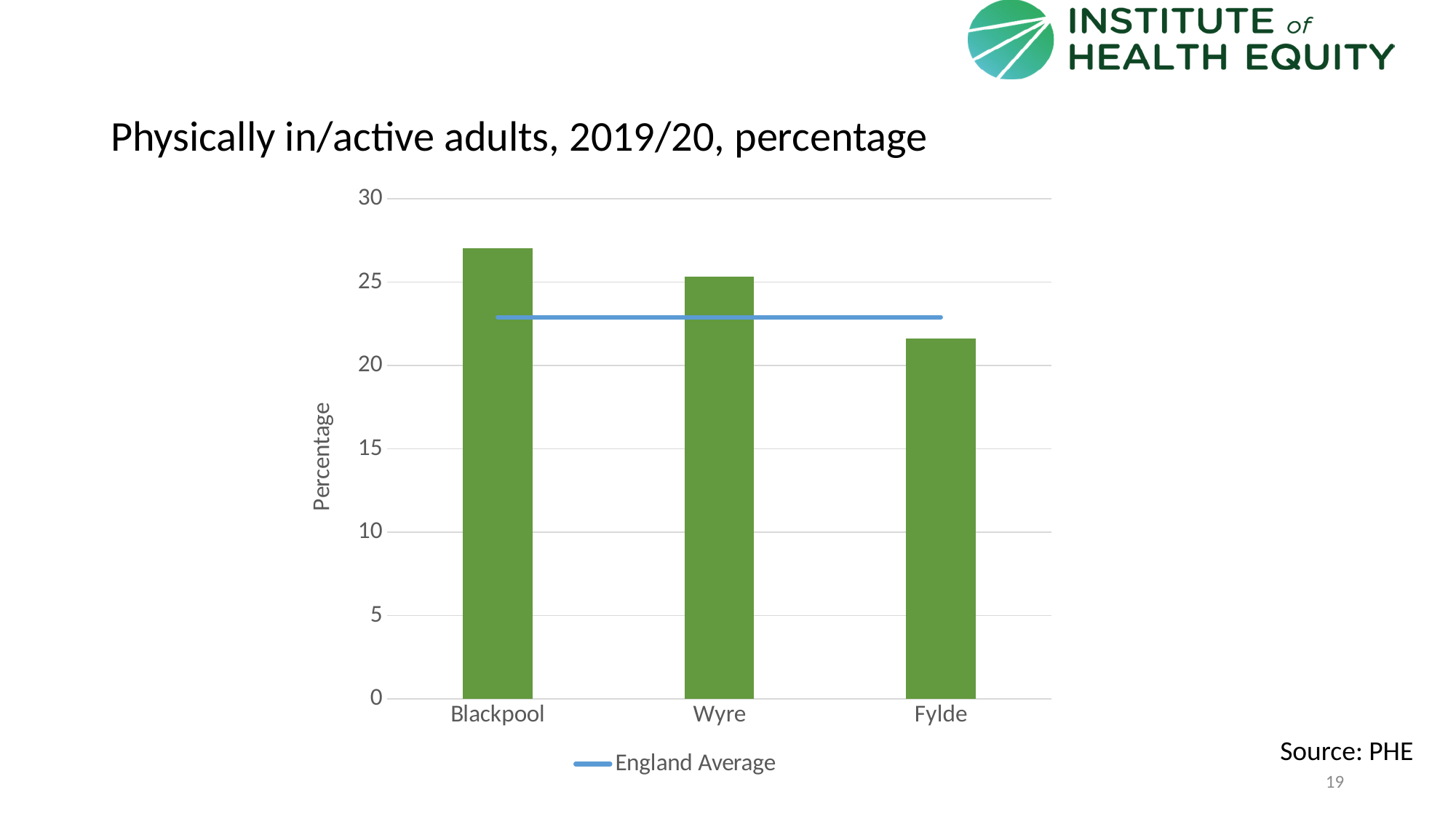
Which area has the highest percentage of physically inactive adults? Blackpool Which is larger, the value for Wyre or the value for Fylde? Wyre How many entries does the legend list? 1 Is the value for Wyre greater or less than 20? greater Is the value for Blackpool greater or less than 25? greater Do the bar values rise or fall from Blackpool to Fylde along the x axis? fall Is the England Average line above or below 25? below What kind of chart is shown on the slide? combination bar and line chart (bars with an England Average line) How many areas (bars) are plotted on the chart? 3 What is the label on the vertical axis? Percentage Which area has the lowest percentage of physically inactive adults? Fylde